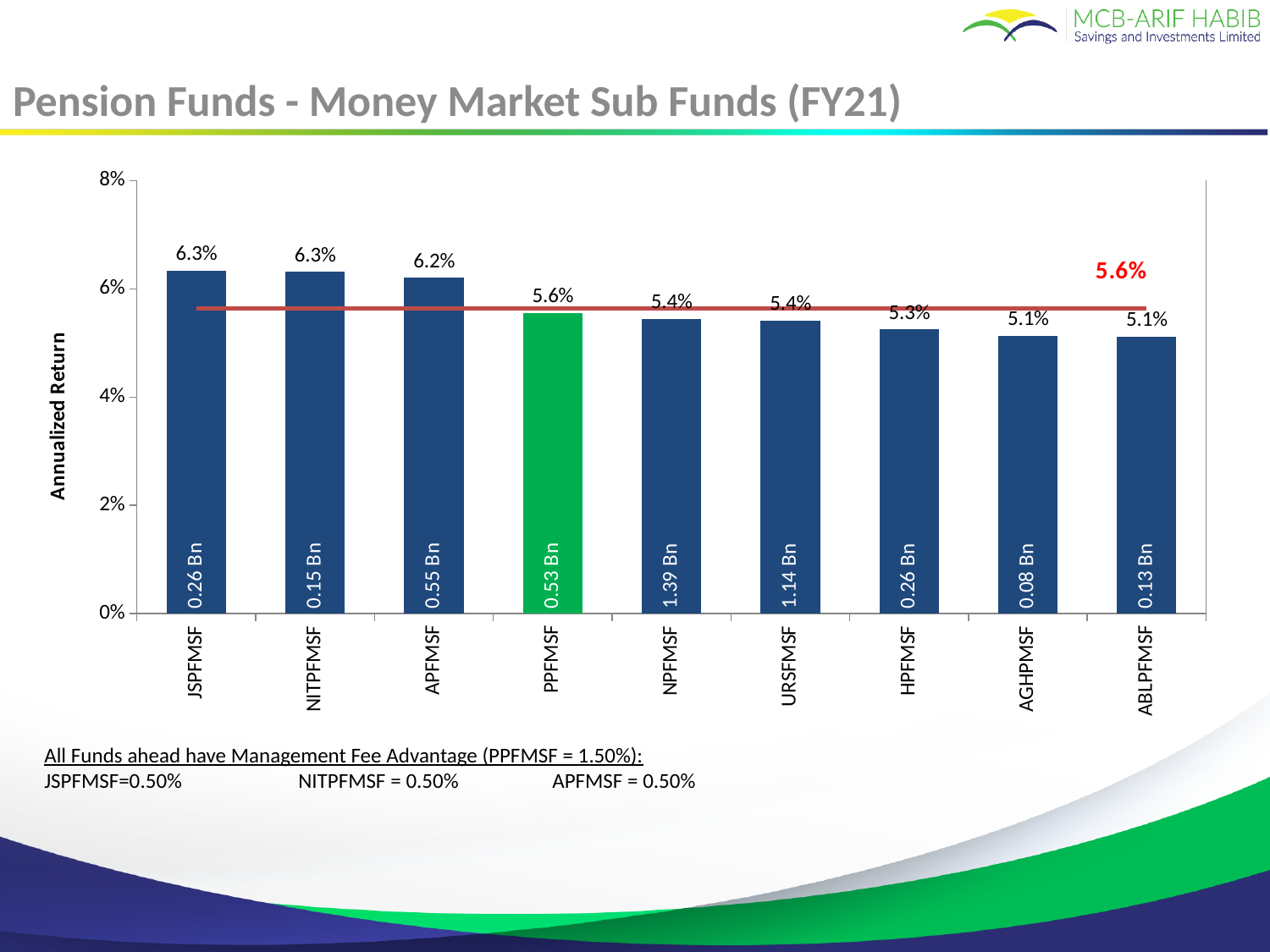
What fund size is printed inside the AGHPMSF bar? 0.08 Bn What is the annualized return for APFMSF? 6.2% What is the difference in annualized return between JSPFMSF and PPFMSF? 0.7% What is the annualized return for PPFMSF? 5.6% What is the annualized return for HPFMSF? 5.3% Is the annualized return for JSPFMSF greater or less than 6%? greater What kind of chart is shown on the slide? bar chart What is the difference in annualized return between APFMSF and ABLPFMSF? 1.1% What fund size is printed inside the NPFMSF bar? 1.39 Bn How many funds are shown on the chart? 9 Which has a higher annualized return, NITPFMSF or URSFMSF? NITPFMSF Do the annualized returns rise or fall from left to right across the chart? fall